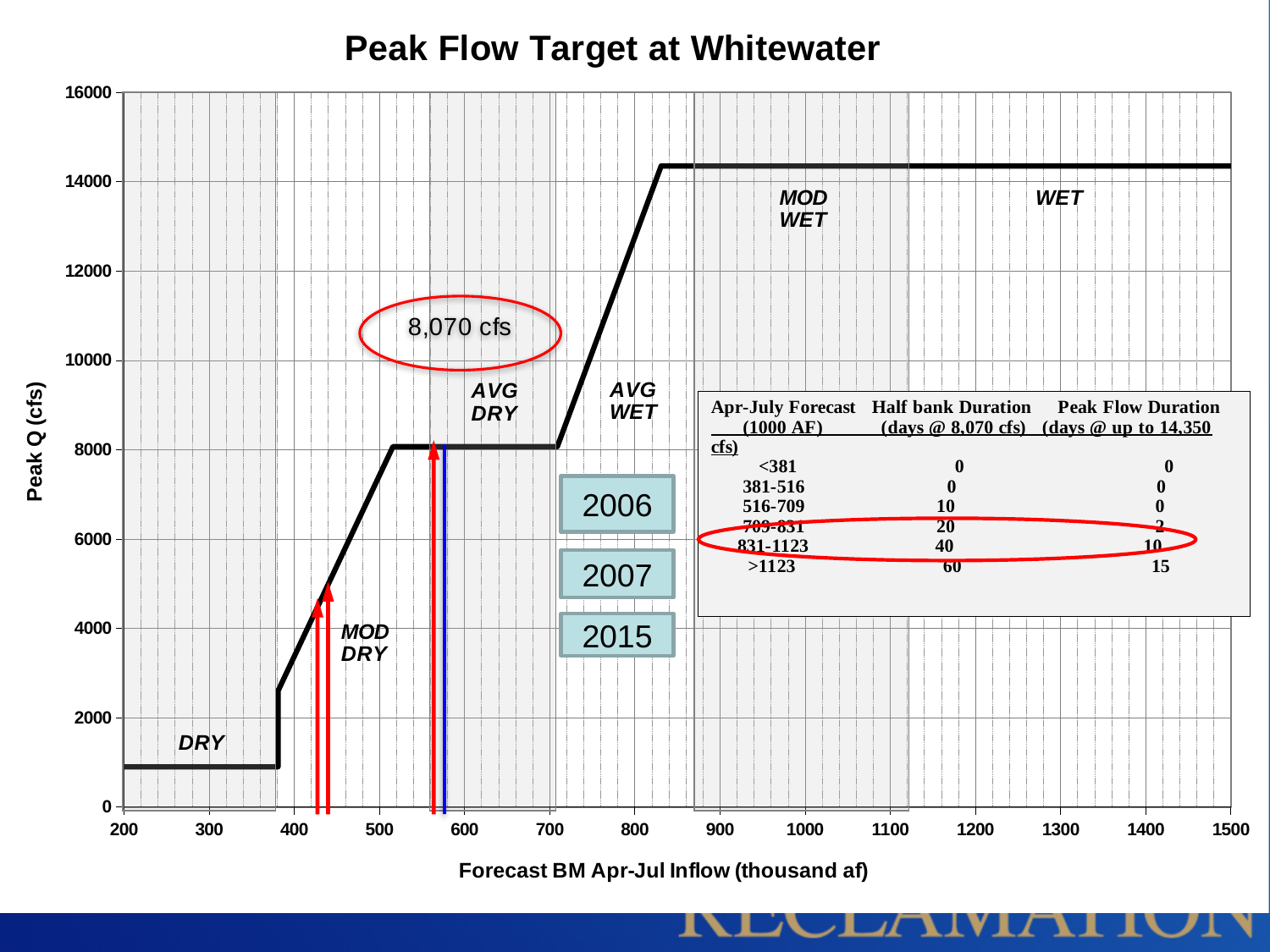
Is the peak flow target at a forecast inflow of 600 thousand af greater or less than 10000 cfs? less What peak flow value is circled on the chart for the middle plateau of the line? 8,070 cfs Is the peak flow target at a forecast inflow of 1200 thousand af greater or less than 14000 cfs? greater What is the title of the chart? Peak Flow Target at Whitewater How many hydrologic condition zones (DRY, MOD DRY, etc.) are labeled on the chart? 6 In the table on the chart, what is the Half bank Duration for an Apr-July Forecast of 831-1123? 40 Is the peak flow target at a forecast inflow of 300 thousand af greater or less than 2000 cfs? less Which forecast range in the table has the highest Half bank Duration? >1123 What kind of chart is shown on the slide? line chart What is the label of the x axis of the chart? Forecast BM Apr-Jul Inflow (thousand af) In the table on the chart, what is the Peak Flow Duration for an Apr-July Forecast of >1123? 15 Does the peak flow target generally rise or fall as the forecast inflow increases along the x axis? rise